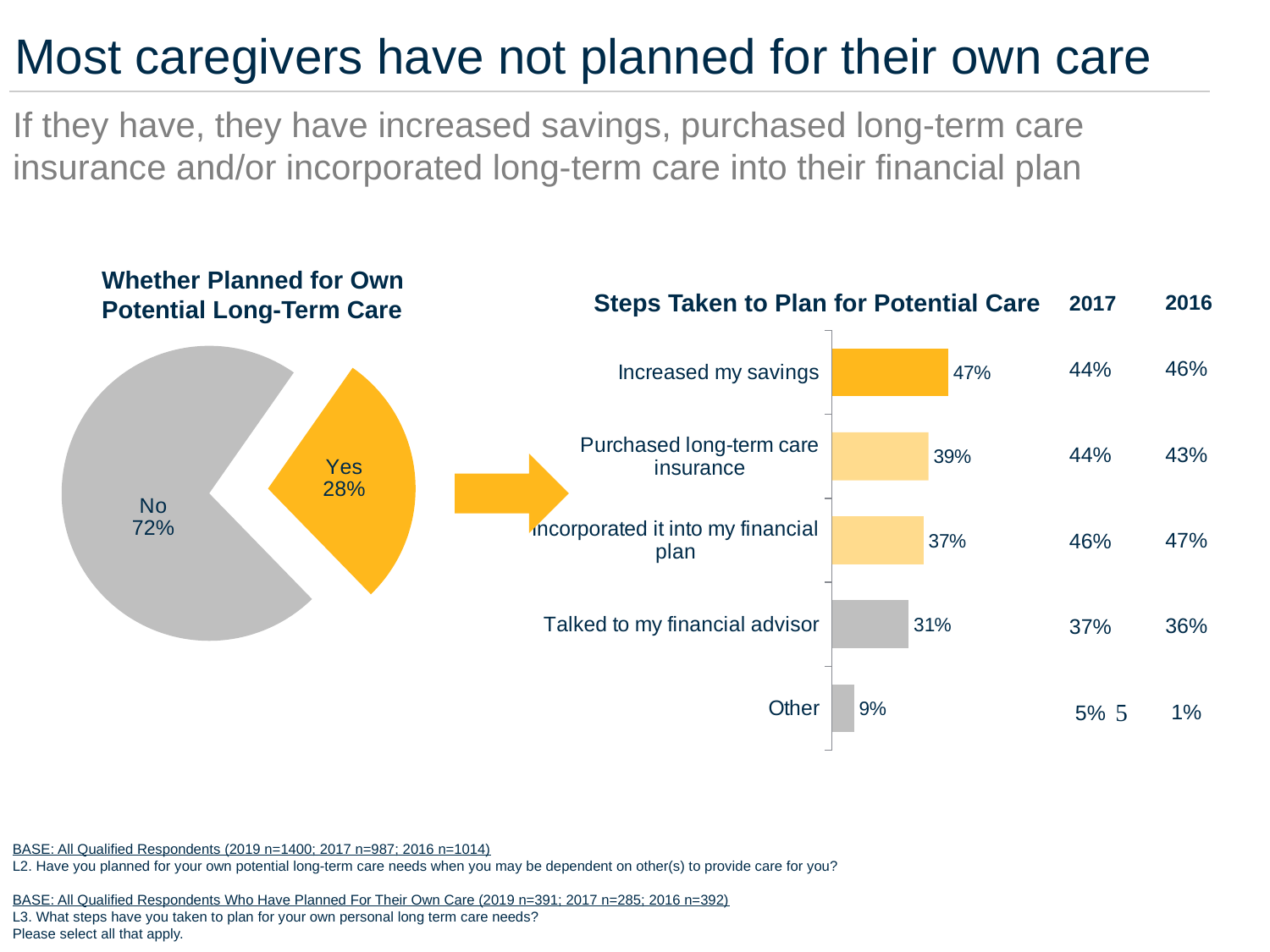
In the 'Steps Taken to Plan for Potential Care' chart, which is larger: 'Increased my savings' or 'Talked to my financial advisor'? Increased my savings In the 'Steps Taken to Plan for Potential Care' chart, how many steps (categories) are plotted? 5 In the 'Steps Taken to Plan for Potential Care' chart, which step has the lowest value? Other In the 'Steps Taken to Plan for Potential Care' chart, what is the difference between 'Purchased long-term care insurance' and 'Incorporated it into my financial plan'? 2% In the 'Whether Planned for Own Potential Long-Term Care' chart, how many slices does the pie have? 2 In the 'Steps Taken to Plan for Potential Care' chart, which step has the highest value? Increased my savings In the 'Whether Planned for Own Potential Long-Term Care' chart, what percentage of caregivers answered No? 72% In the 'Steps Taken to Plan for Potential Care' chart, what is the value for 'Increased my savings'? 47% What kind of chart is 'Whether Planned for Own Potential Long-Term Care'? Pie chart In the 'Steps Taken to Plan for Potential Care' chart, what is the value for 'Talked to my financial advisor'? 31% In the 'Whether Planned for Own Potential Long-Term Care' chart, what percentage of caregivers answered Yes? 28% What kind of chart is 'Steps Taken to Plan for Potential Care'? Bar chart